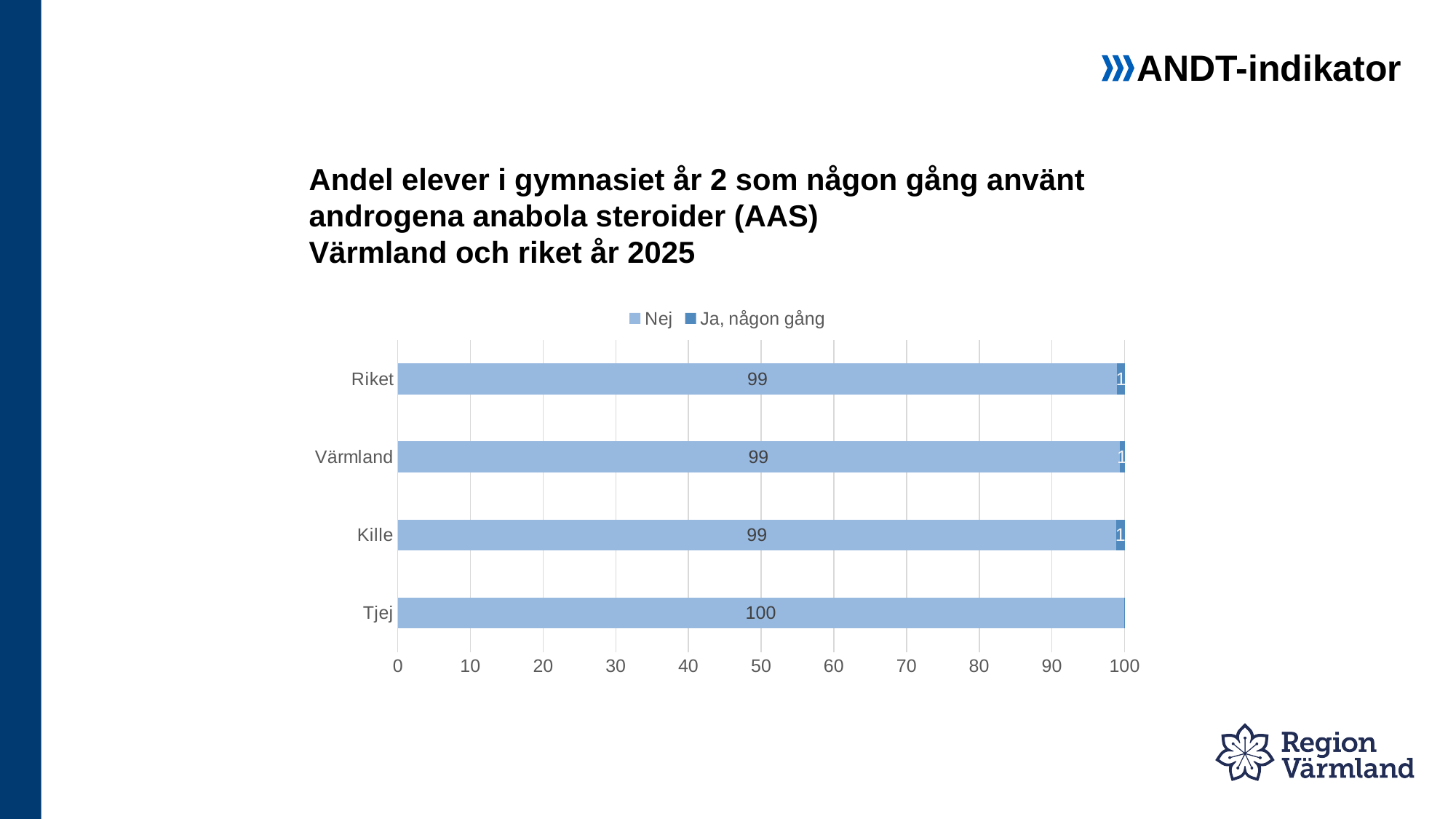
How many series does the legend list? 2 What is the difference between the "Nej" value for Tjej and the "Nej" value for Kille? 1 What kind of chart is shown on the slide? Stacked bar chart How many categories are shown on the y axis of the chart? 4 What is the total of the stacked bar for Riket? 100 For Riket, which series has the larger value, "Nej" or "Ja, någon gång"? Nej What is the value of the "Nej" series for Tjej? 100 What is the value of the "Nej" series for Värmland? 99 What is the value of the "Nej" series for Riket? 99 What is the value of the "Ja, någon gång" series for Kille? 1 Which category has the highest value for the "Nej" series? Tjej Is the "Nej" value for Värmland greater or less than 90? greater